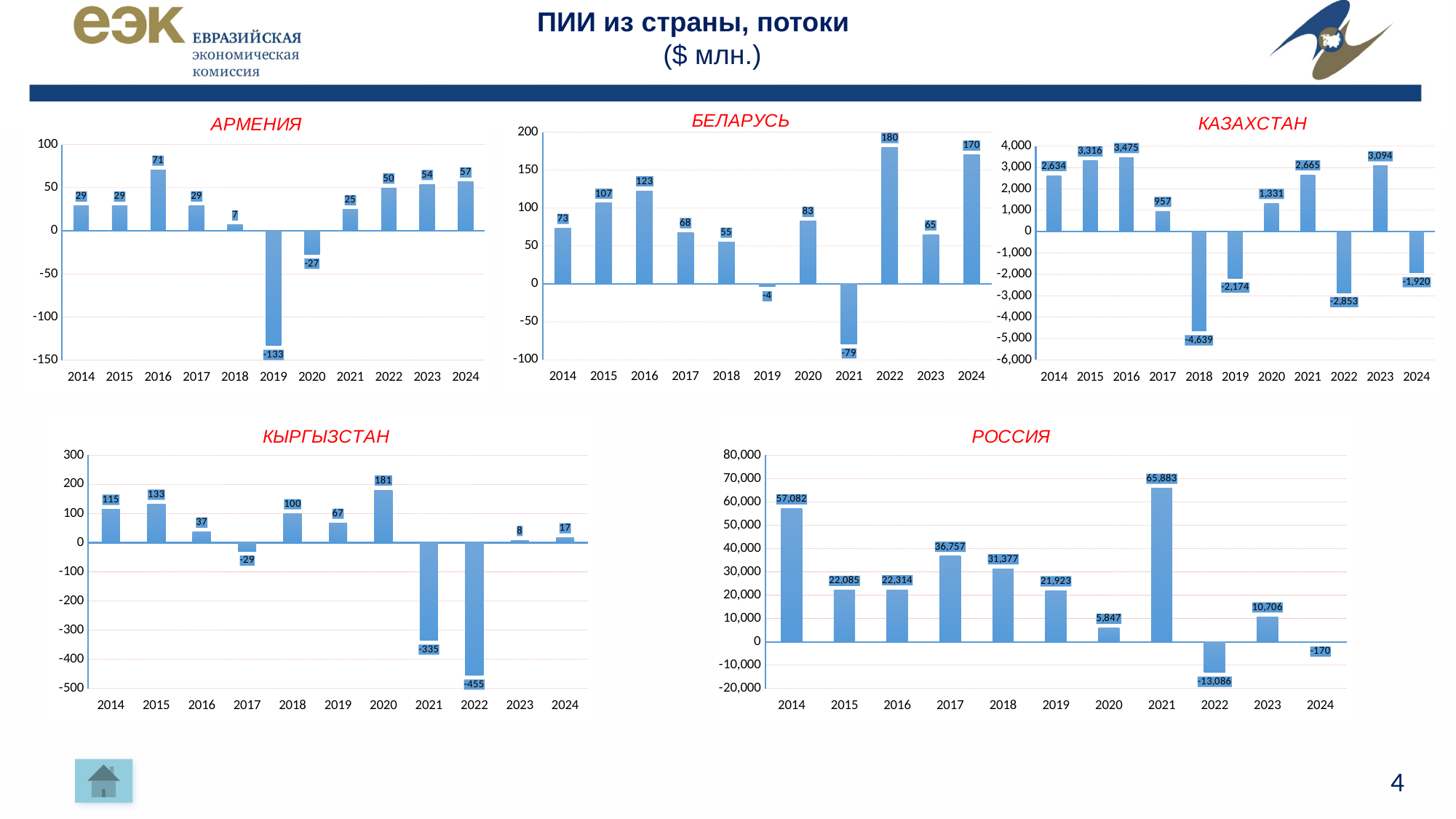
In the КАЗАХСТАН chart, which year has the lowest value? 2018 In the КЫРГЫЗСТАН chart, what is the value for 2022? -455 In the БЕЛАРУСЬ chart, what is the difference between the values for 2022 and 2024? 10 In the РОССИЯ chart, do the values rise or fall from 2017 to 2020? Fall What type of chart is the КЫРГЫЗСТАН chart? Bar chart In the АРМЕНИЯ chart, what is the value for 2019? -133 In the БЕЛАРУСЬ chart, which year has the highest value? 2022 In the РОССИЯ chart, what is the difference between the values for 2014 and 2015? 34,997 How many years are shown on the x axis of the АРМЕНИЯ chart? 11 In the РОССИЯ chart, what is the value for 2021? 65,883 How many charts are shown on the slide? 5 In the КАЗАХСТАН chart, which year has the larger value, 2016 or 2023? 2016